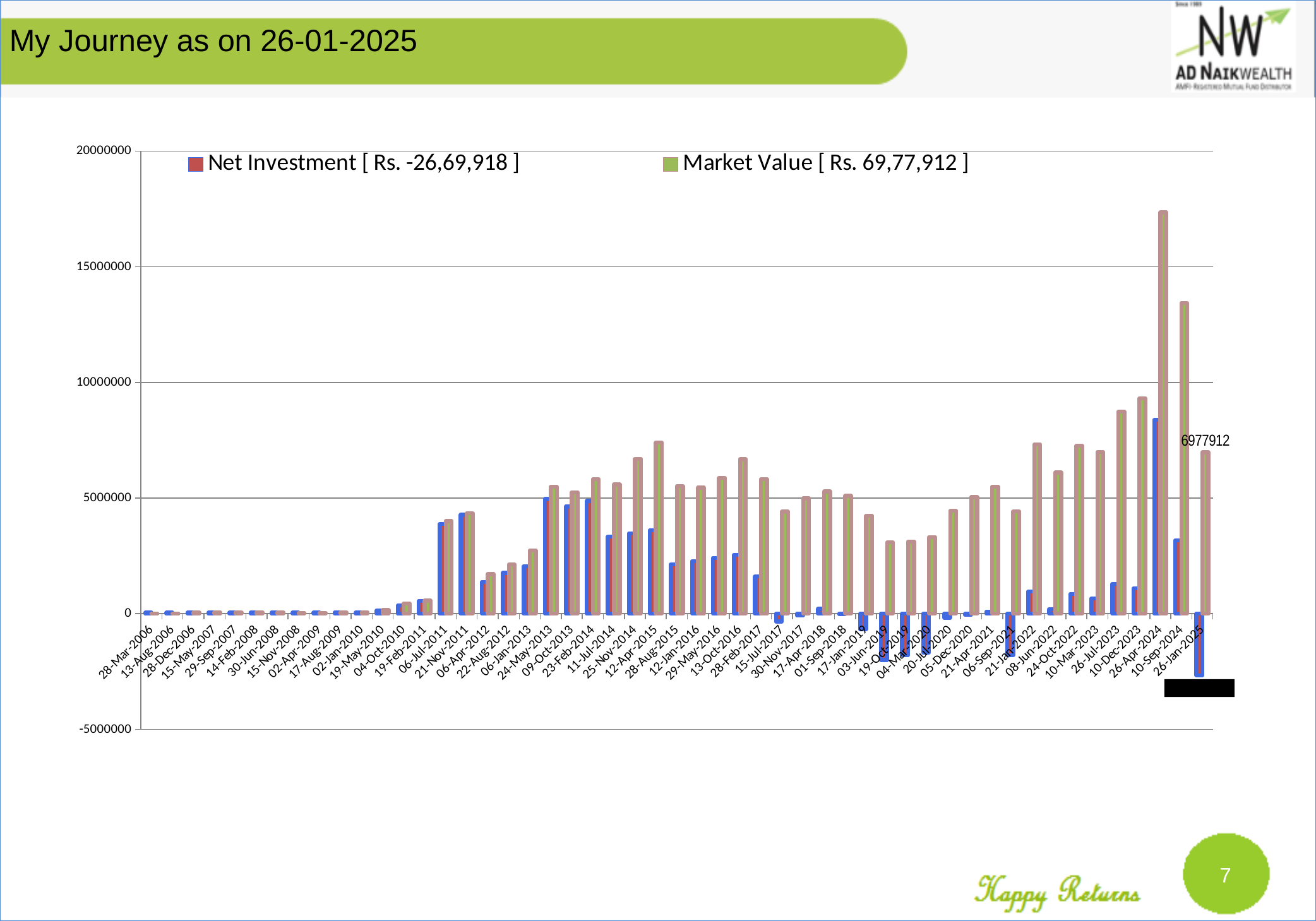
Which date has the highest Market Value bar? 26-Apr-2024 What total is shown in the legend entry for Market Value? Rs. 69,77,912 How many series does the legend list? 2 Is the Market Value for 26-Apr-2024 greater or less than 15000000? greater What kind of chart is shown on the slide? bar chart What total is shown in the legend entry for Net Investment? Rs. -26,69,918 Which date has the larger Market Value, 26-Apr-2024 or 10-Sep-2024? 26-Apr-2024 Is the Net Investment for 26-Jan-2025 greater or less than 0? less Which date has the lowest Net Investment bar? 26-Jan-2025 Which is larger for 26-Apr-2024, Net Investment or Market Value? Market Value Is the Market Value for 10-Sep-2024 greater or less than 10000000? greater What is the Market Value for 26-Jan-2025? 6977912